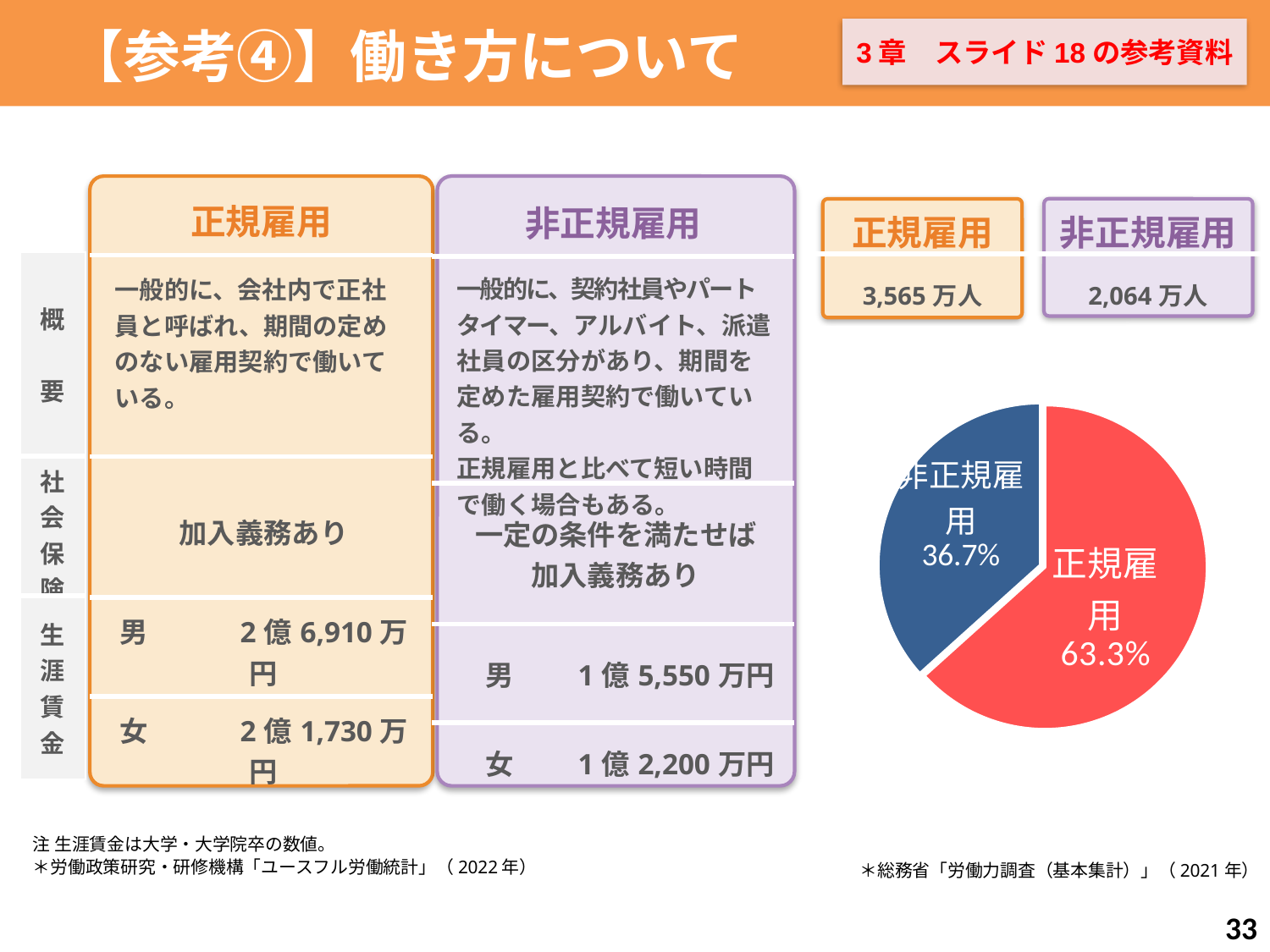
What colour is the 正規雇用 slice of the pie chart? red Which slice of the pie chart is the smallest? 非正規雇用 What share of the pie chart does 非正規雇用 represent? 36.7% Which is larger in the pie chart, 正規雇用 or 非正規雇用? 正規雇用 What share of the pie chart does 正規雇用 represent? 63.3% Is the share for 非正規雇用 in the pie chart greater or less than 50%? less What kind of chart is shown on the slide? pie chart How many slices does the pie chart have? 2 Which slice of the pie chart is the largest? 正規雇用 What is the difference in percentage points between the 正規雇用 slice and the 非正規雇用 slice? 26.6 What colour is the 非正規雇用 slice of the pie chart? blue